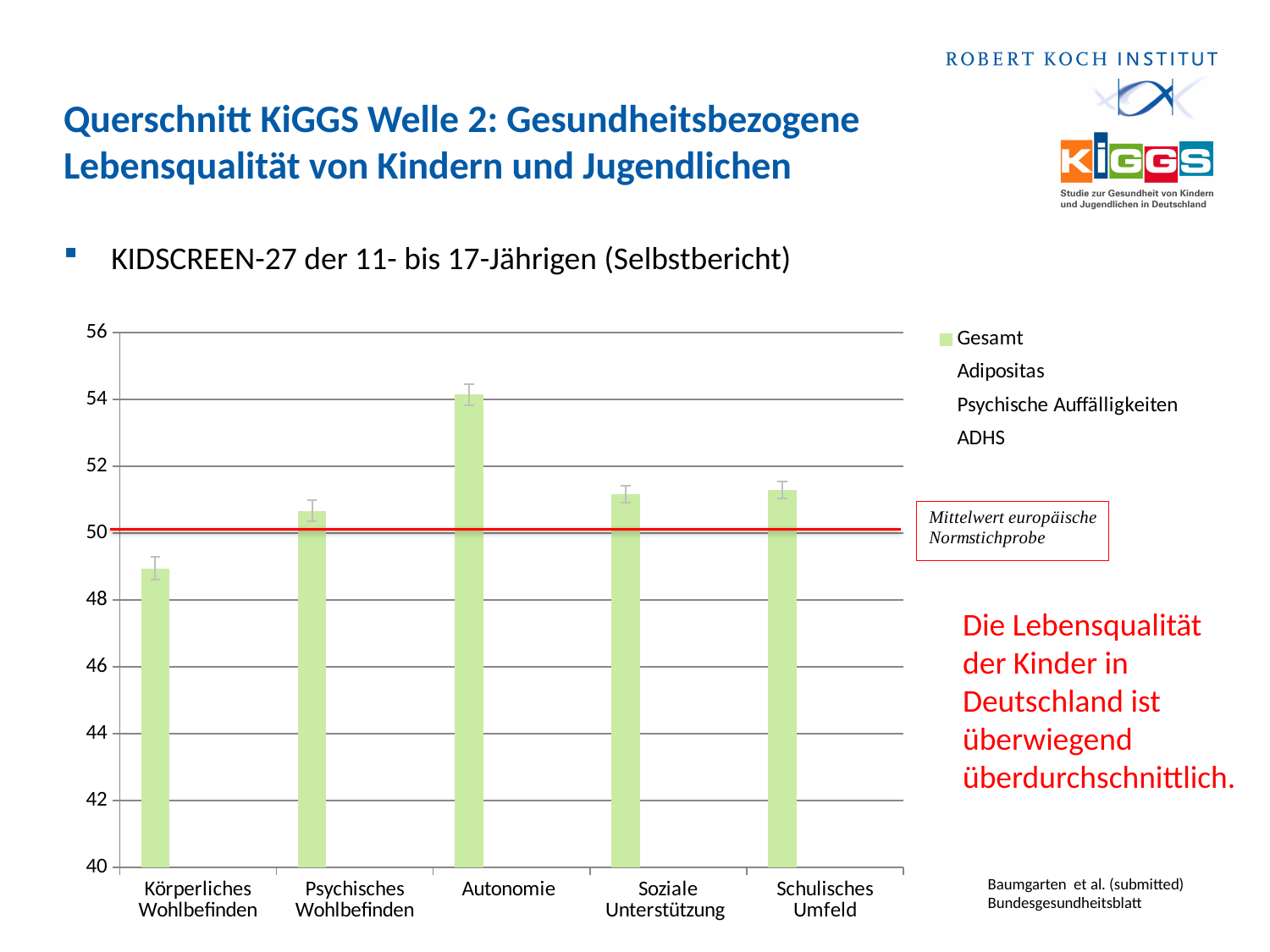
How many series does the chart's legend list? 4 Is the value for Körperliches Wohlbefinden greater or less than 50? less Is the value for Soziale Unterstützung greater or less than 50? greater Is the value for Schulisches Umfeld greater or less than 52? less Which category has the highest bar in the chart? Autonomie Which is larger, the value for Körperliches Wohlbefinden or the value for Soziale Unterstützung? Soziale Unterstützung What does the red horizontal line in the chart represent, according to its label? Mittelwert europäische Normstichprobe Which is larger, the value for Autonomie or the value for Psychisches Wohlbefinden? Autonomie Which category has the lowest bar in the chart? Körperliches Wohlbefinden What kind of chart is shown on the slide? bar chart How many categories are shown on the x axis of the chart? 5